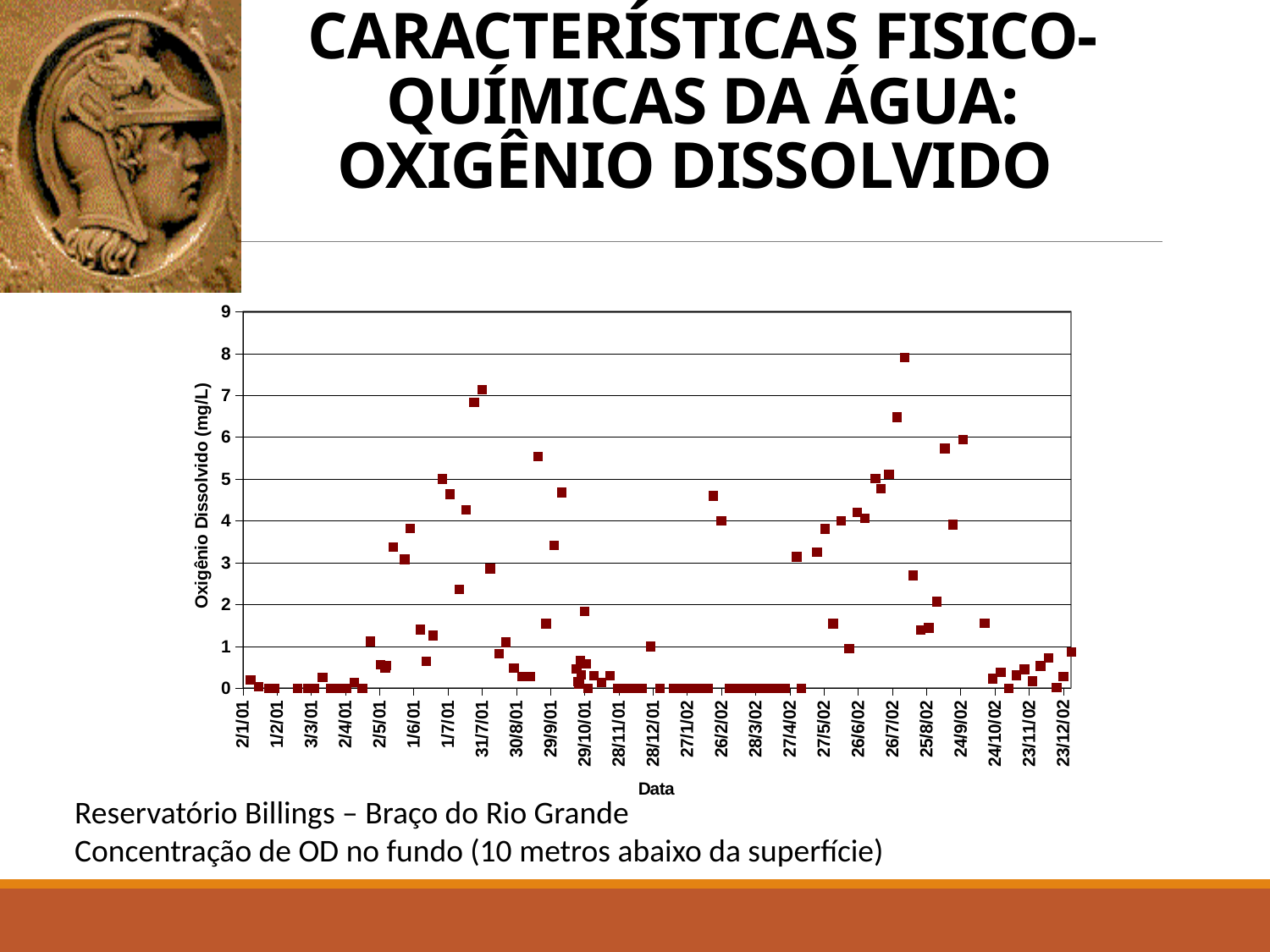
What kind of chart is shown on the slide? scatter chart Are the values plotted around 28/3/02 greater or less than 1? less What is the label of the horizontal axis of the chart? Data What is the last date label shown on the horizontal axis? 23/12/02 What is the highest tick value shown on the vertical axis? 9 Are the values plotted around 1/2/01 greater or less than 1? less Is the highest plotted dissolved oxygen value greater or less than 7? greater What is the first date label shown on the horizontal axis? 2/1/01 How many date labels are shown on the horizontal axis? 25 What is the label of the vertical axis of the chart? Oxigênio Dissolvido (mg/L) Between 2/5/01 and 1/7/01, do the plotted values generally rise or fall? rise